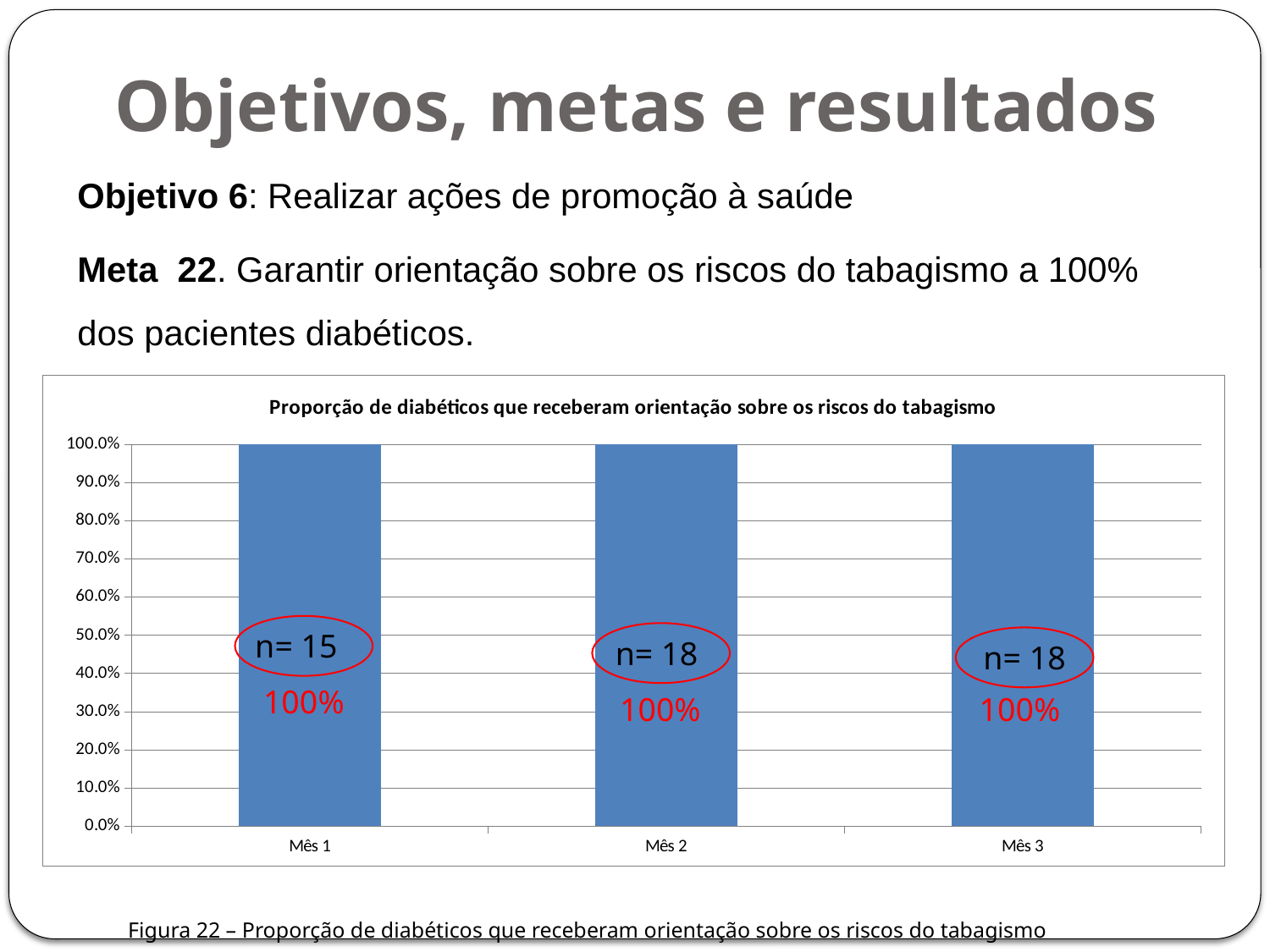
Is the value for Mês 2 greater or less than 90.0%? greater What is the value shown for Mês 1? 100% What is the value shown for Mês 3? 100% What is the n value labelled on the bar for Mês 1? n= 15 What is the title of the chart? Proporção de diabéticos que receberam orientação sobre os riscos do tabagismo What kind of chart is shown on the slide? bar chart Do the values rise, fall or stay the same from Mês 1 to Mês 3? stay the same What is the n value labelled on the bar for Mês 3? n= 18 What is the n value labelled on the bar for Mês 2? n= 18 What is the value shown for Mês 2? 100% What is the difference between the values for Mês 1 and Mês 3? 0% How many months (categories) are plotted in the chart? 3